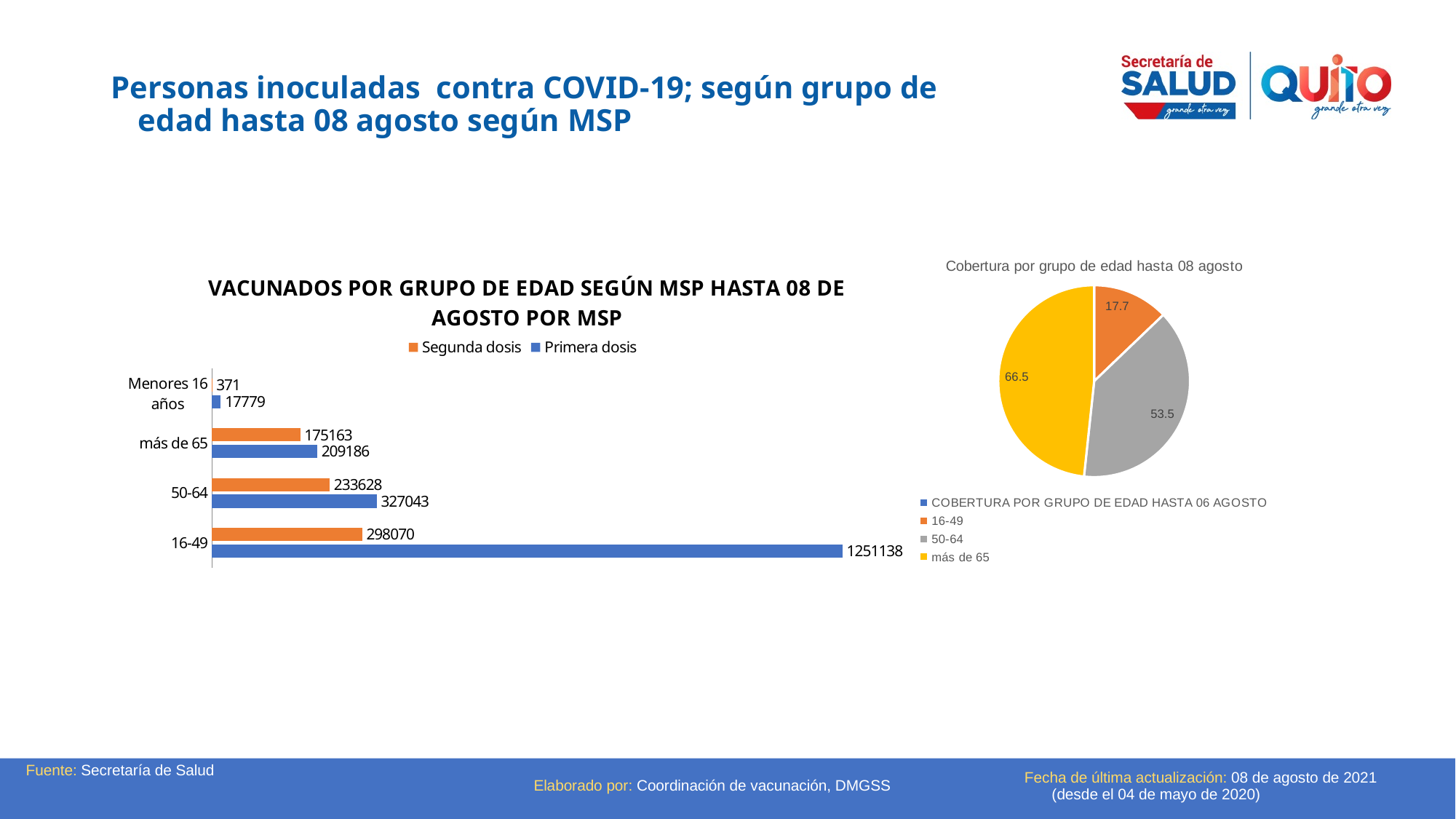
In the bar chart 'VACUNADOS POR GRUPO DE EDAD SEGÚN MSP HASTA 08 DE AGOSTO POR MSP', which age group has the highest Primera dosis value? 16-49 In the bar chart 'VACUNADOS POR GRUPO DE EDAD SEGÚN MSP HASTA 08 DE AGOSTO POR MSP', what is the Primera dosis value for the 16-49 group? 1251138 How many series does the legend of the bar chart 'VACUNADOS POR GRUPO DE EDAD SEGÚN MSP HASTA 08 DE AGOSTO POR MSP' list? 2 In the bar chart 'VACUNADOS POR GRUPO DE EDAD SEGÚN MSP HASTA 08 DE AGOSTO POR MSP', which is larger for the 50-64 group: Primera dosis or Segunda dosis? Primera dosis In the pie chart 'Cobertura por grupo de edad hasta 08 agosto', which age group has the smallest slice? 16-49 How many age groups are shown in the bar chart 'VACUNADOS POR GRUPO DE EDAD SEGÚN MSP HASTA 08 DE AGOSTO POR MSP'? 4 In the bar chart 'VACUNADOS POR GRUPO DE EDAD SEGÚN MSP HASTA 08 DE AGOSTO POR MSP', what is the Segunda dosis value for the 50-64 group? 233628 In the pie chart 'Cobertura por grupo de edad hasta 08 agosto', what value is shown for the más de 65 slice? 66.5 In the bar chart 'VACUNADOS POR GRUPO DE EDAD SEGÚN MSP HASTA 08 DE AGOSTO POR MSP', what is the Segunda dosis value for Menores 16 años? 371 In the bar chart 'VACUNADOS POR GRUPO DE EDAD SEGÚN MSP HASTA 08 DE AGOSTO POR MSP', what is the difference between the Primera dosis and Segunda dosis values for the más de 65 group? 34023 What kind of chart is 'Cobertura por grupo de edad hasta 08 agosto'? Pie chart In the bar chart 'VACUNADOS POR GRUPO DE EDAD SEGÚN MSP HASTA 08 DE AGOSTO POR MSP', which age group has the lowest Segunda dosis value? Menores 16 años